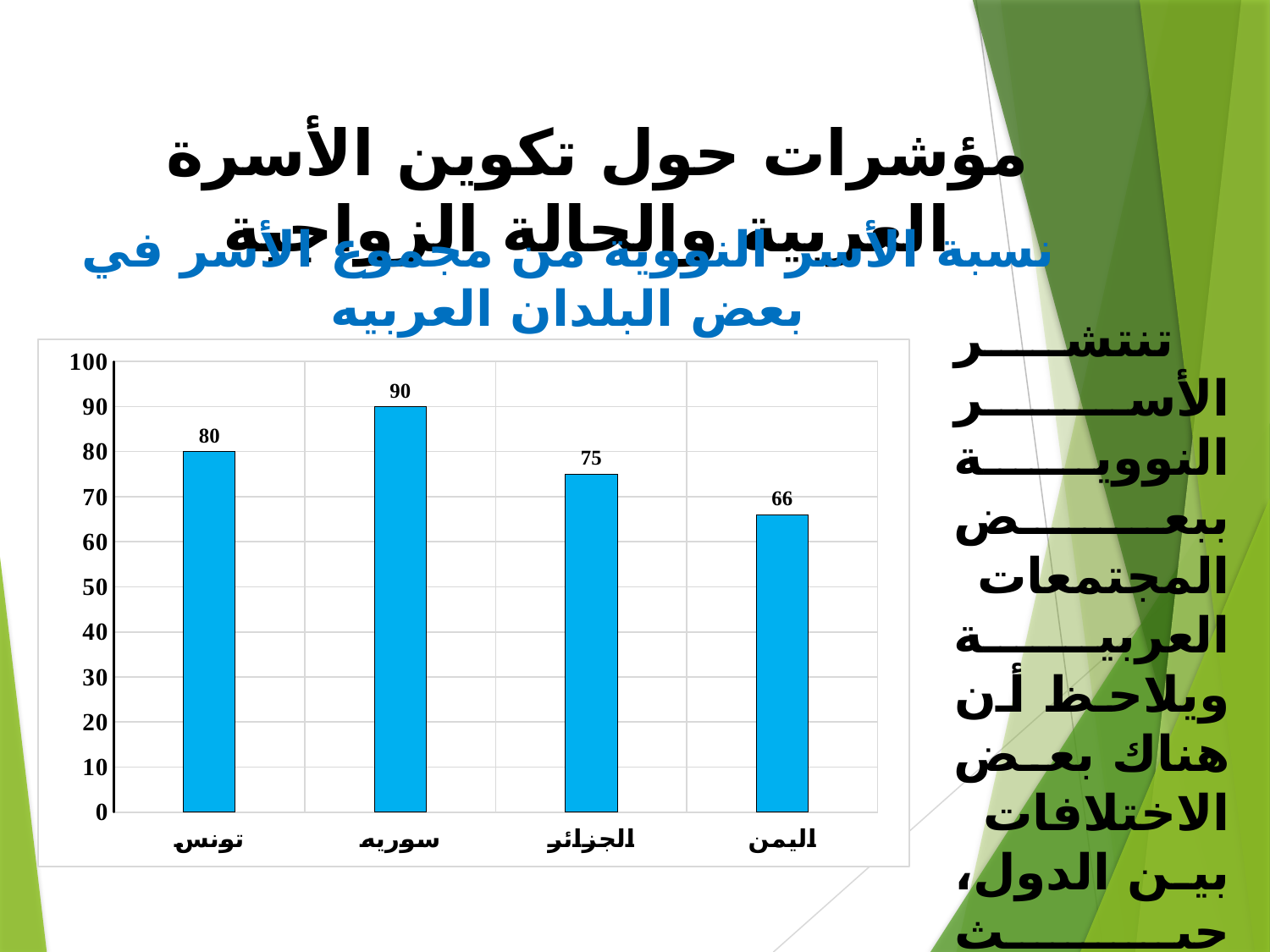
Is the value for اليمن greater or less than 70? less Which is larger, the value for تونس or the value for الجزائر? تونس How many countries are shown in the chart? 4 Which country has the highest value? سوريه What kind of chart is shown on the slide? bar chart What is the difference between the values for تونس and الجزائر? 5 What is the value for الجزائر? 75 What is the value for تونس? 80 Which country has the lowest value? اليمن What is the value for اليمن? 66 What is the difference between the values for سوريه and اليمن? 24 What is the value for سوريه? 90